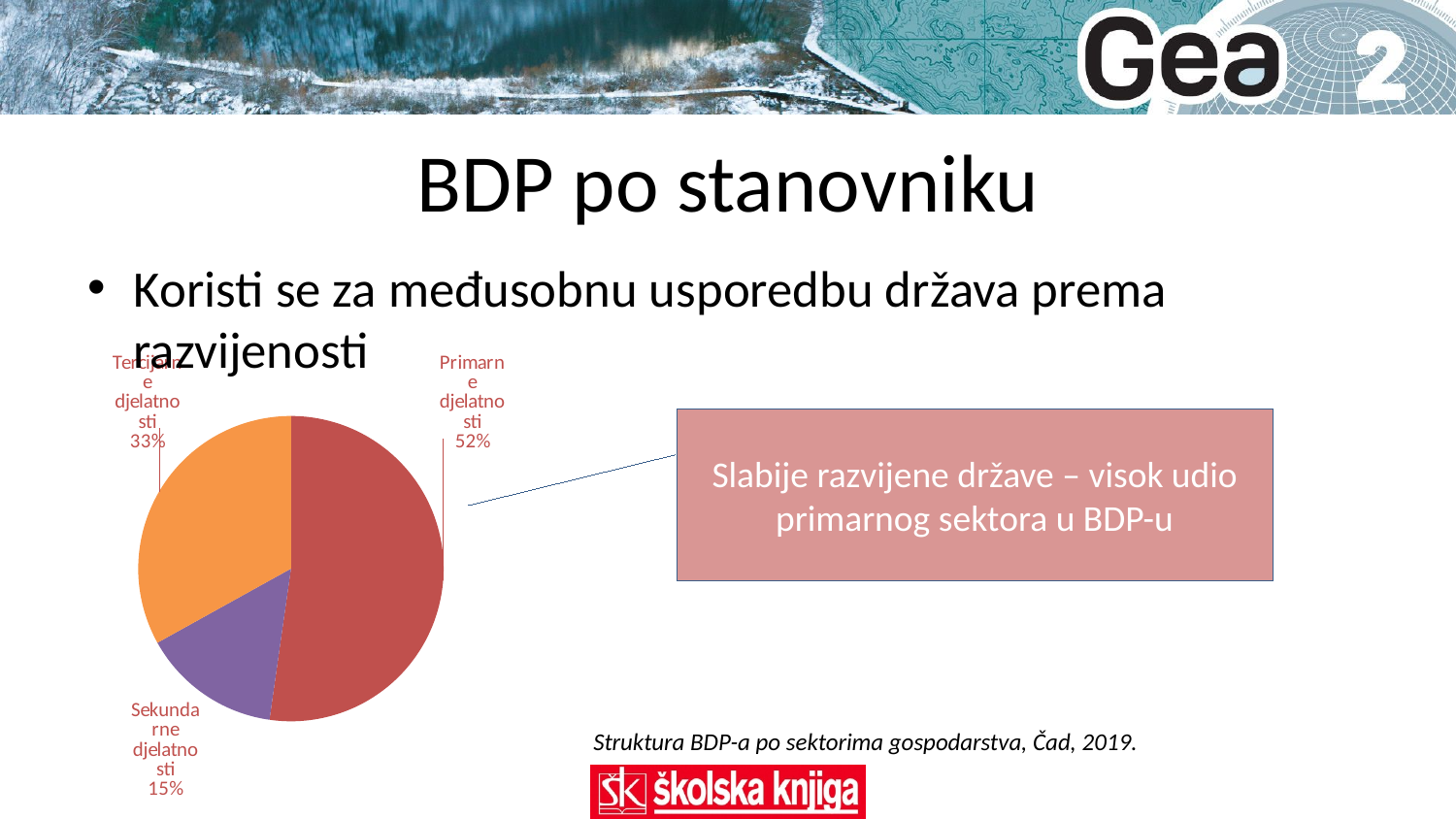
Which is larger, the share of Tercijarne djelatnosti or Sekundarne djelatnosti? Tercijarne djelatnosti What kind of chart is shown on the slide? pie chart What colour is the Primarne djelatnosti slice? red Which sector has the smallest share of the pie? Sekundarne djelatnosti How many slices does the pie chart have? 3 What share of the pie is Primarne djelatnosti? 52% What is the difference in percentage points between Primarne djelatnosti and Tercijarne djelatnosti? 19 Which country and year does the pie chart caption say the data is for? Čad, 2019 Which sector has the largest share of the pie? Primarne djelatnosti What share of the pie is Sekundarne djelatnosti? 15% What is the difference in percentage points between Tercijarne djelatnosti and Sekundarne djelatnosti? 18 What share of the pie is Tercijarne djelatnosti? 33%